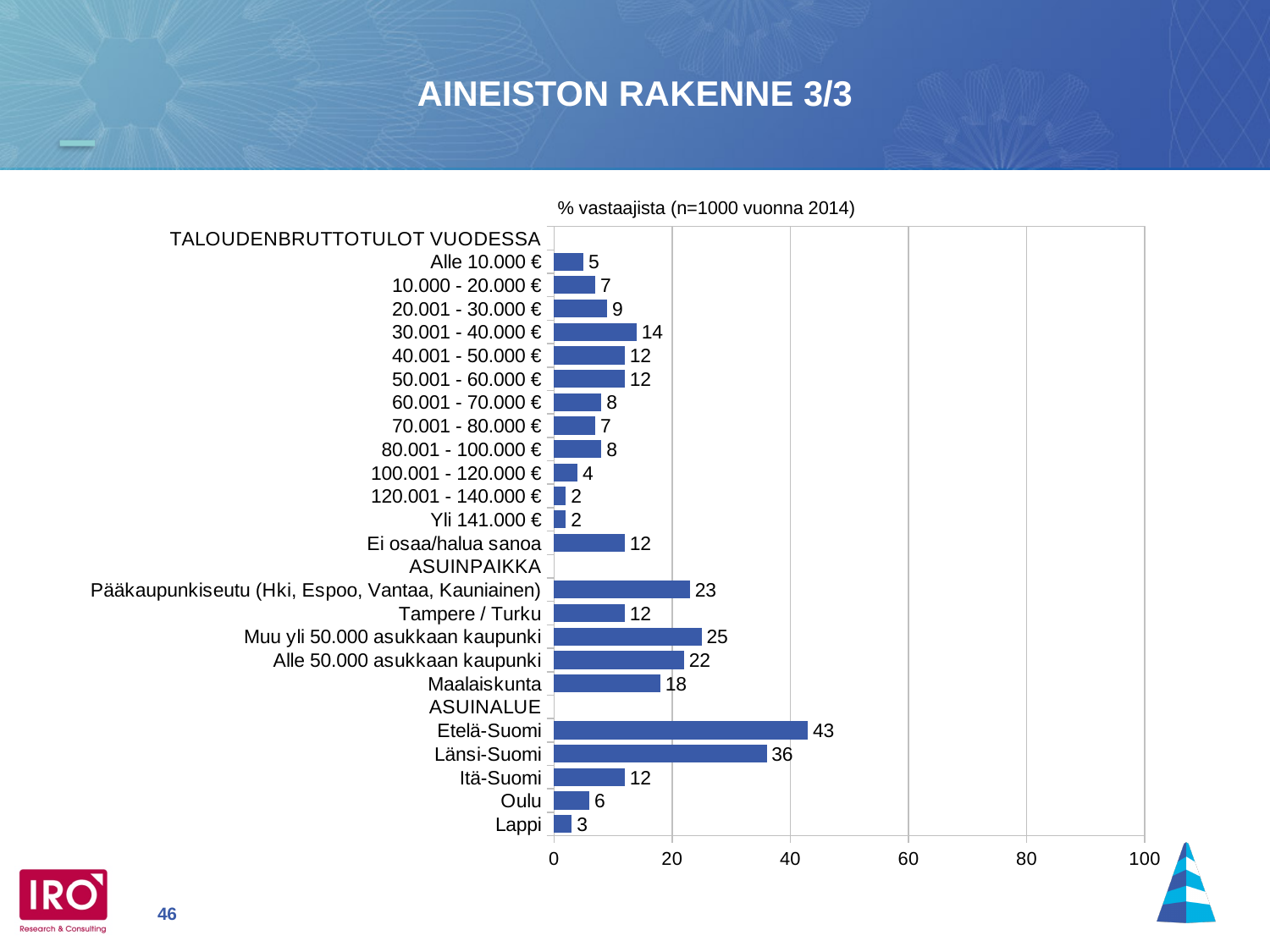
What is the title of the chart? % vastaajista (n=1000 vuonna 2014) Which is larger, the value for Muu yli 50.000 asukkaan kaupunki or Alle 50.000 asukkaan kaupunki? Muu yli 50.000 asukkaan kaupunki Is the value for Länsi-Suomi greater or less than 40? less What is the value for Maalaiskunta? 18 Which income category has the highest value? 30.001 - 40.000 € What is the value for Etelä-Suomi? 43 What is the difference between the values for Etelä-Suomi and Länsi-Suomi? 7 What is the value for Pääkaupunkiseutu (Hki, Espoo, Vantaa, Kauniainen)? 23 Which category has the highest value in the chart? Etelä-Suomi What is the value for 30.001 - 40.000 €? 14 What is the value for Lappi? 3 What kind of chart is shown on the slide? bar chart